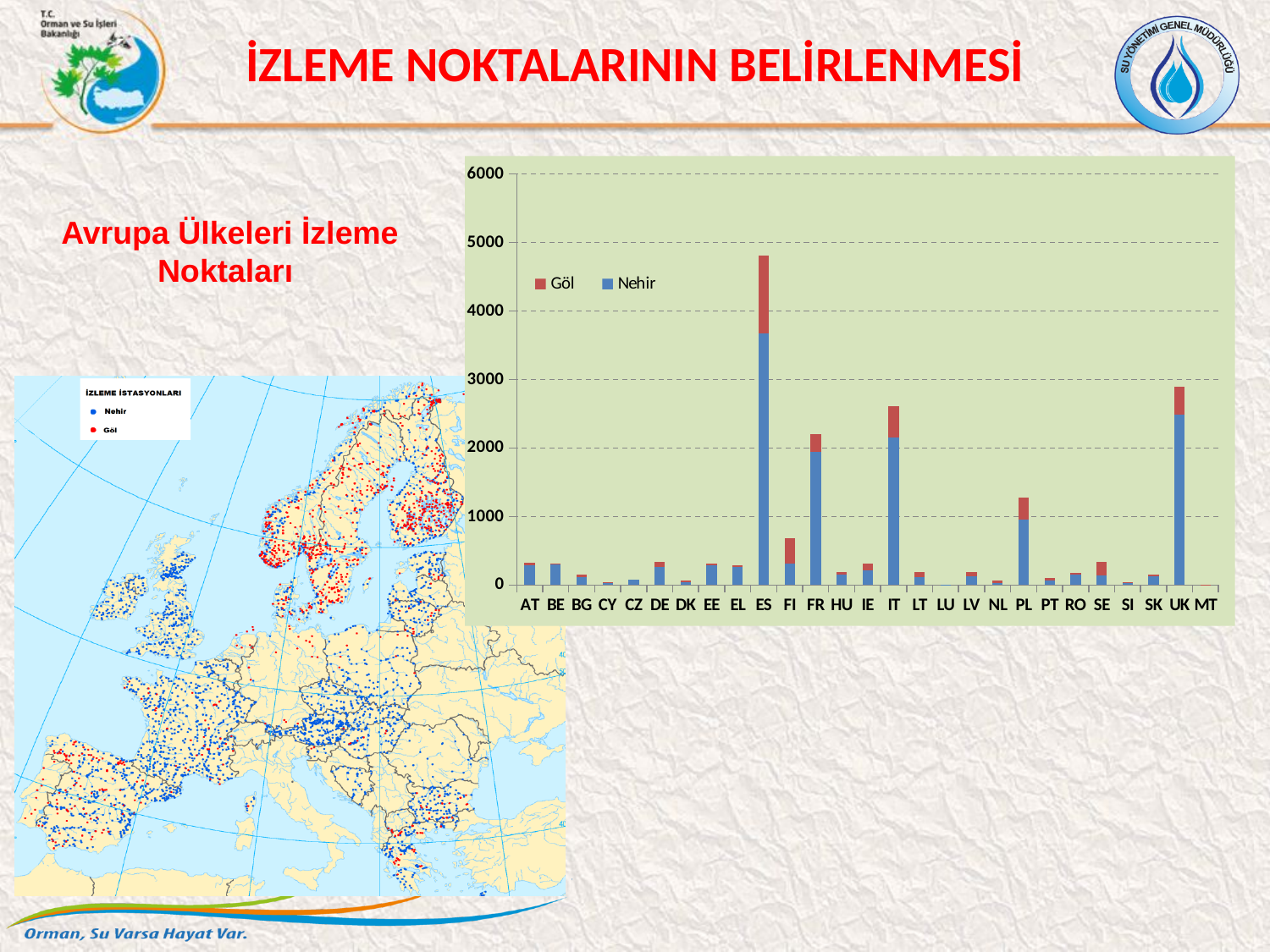
Is the total value for PL greater or less than 2000? less What kind of chart is shown on the slide? bar chart How many countries are shown along the x axis of the chart? 27 Which has the larger total bar, ES or UK? ES How many series does the chart legend list? 2 Which country has the highest total bar in the chart? ES Which colour represents the Nehir series in the chart? blue What are the two series named in the chart legend? Göl and Nehir Is the total value for ES greater or less than 4000? greater Is the total value for UK greater or less than 2000? greater Which has the larger total bar, IT or FR? IT